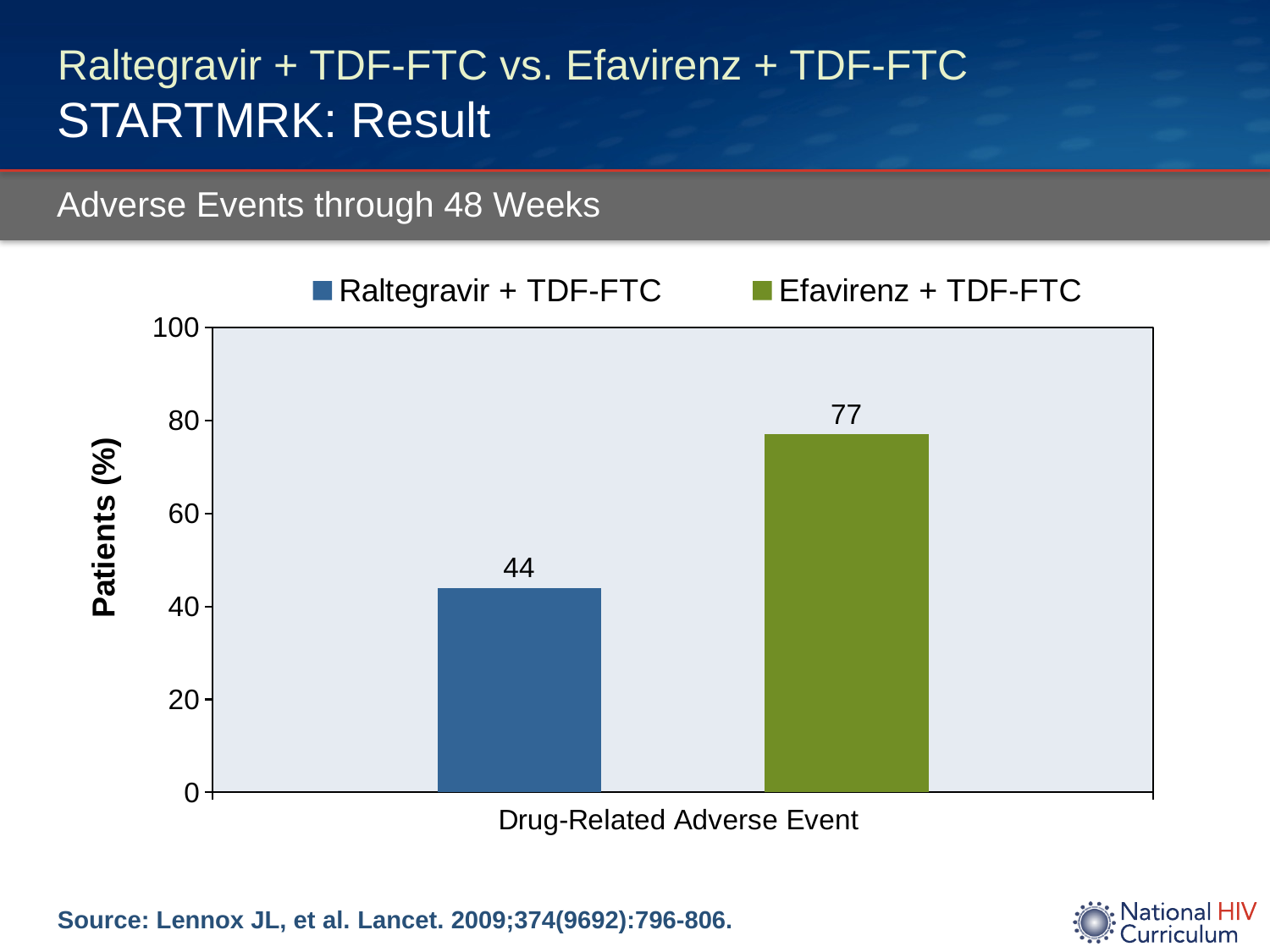
Which series has the lower value for Drug-Related Adverse Event? Raltegravir + TDF-FTC How many categories are shown on the x axis? 1 Which series has the higher value for Drug-Related Adverse Event? Efavirenz + TDF-FTC What is the value for Efavirenz + TDF-FTC for Drug-Related Adverse Event? 77 What is the label of the y axis? Patients (%) What kind of chart is shown on the slide? bar chart What is the value for Raltegravir + TDF-FTC for Drug-Related Adverse Event? 44 Is the value for Raltegravir + TDF-FTC greater or less than 60? less Is the value for Efavirenz + TDF-FTC greater or less than 60? greater What is the difference between the Efavirenz + TDF-FTC and Raltegravir + TDF-FTC values for Drug-Related Adverse Event? 33 How many series does the legend list? 2 Is the value for Raltegravir + TDF-FTC larger or smaller than the value for Efavirenz + TDF-FTC? smaller